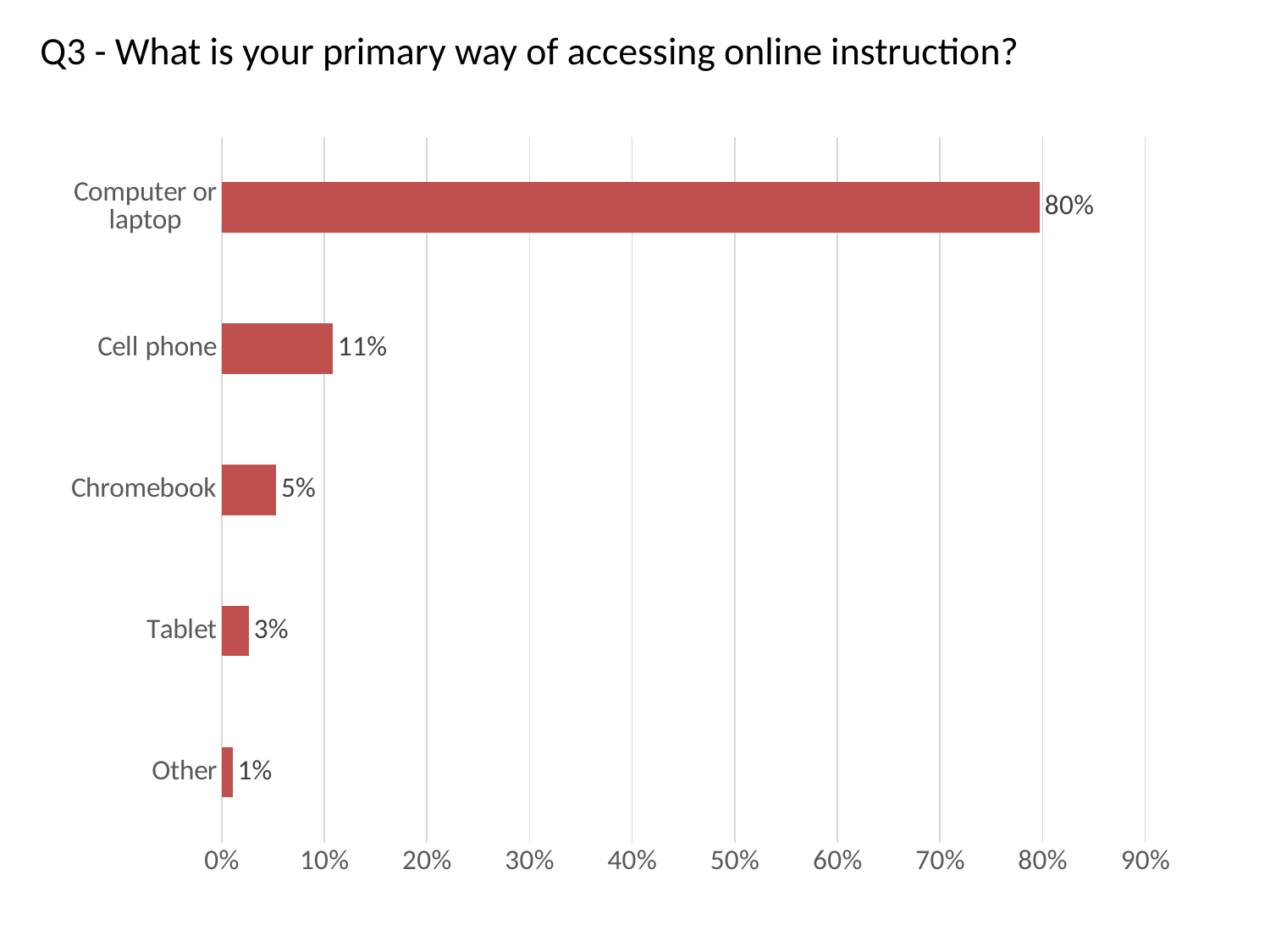
What kind of chart is shown on the slide? Bar chart What is the value shown for Cell phone? 11% What percentage of respondents access online instruction primarily by computer or laptop? 80% How many categories are shown in the chart? 5 What is the difference between the values for Computer or laptop and Cell phone? 69% What is the title of the chart? Q3 - What is your primary way of accessing online instruction? What is the value shown for Tablet? 3% Is the value for Cell phone greater or less than 20%? less Which is larger, the value for Chromebook or the value for Tablet? Chromebook Which category has the highest value? Computer or laptop What is the value shown for Chromebook? 5% Which category has the lowest value? Other